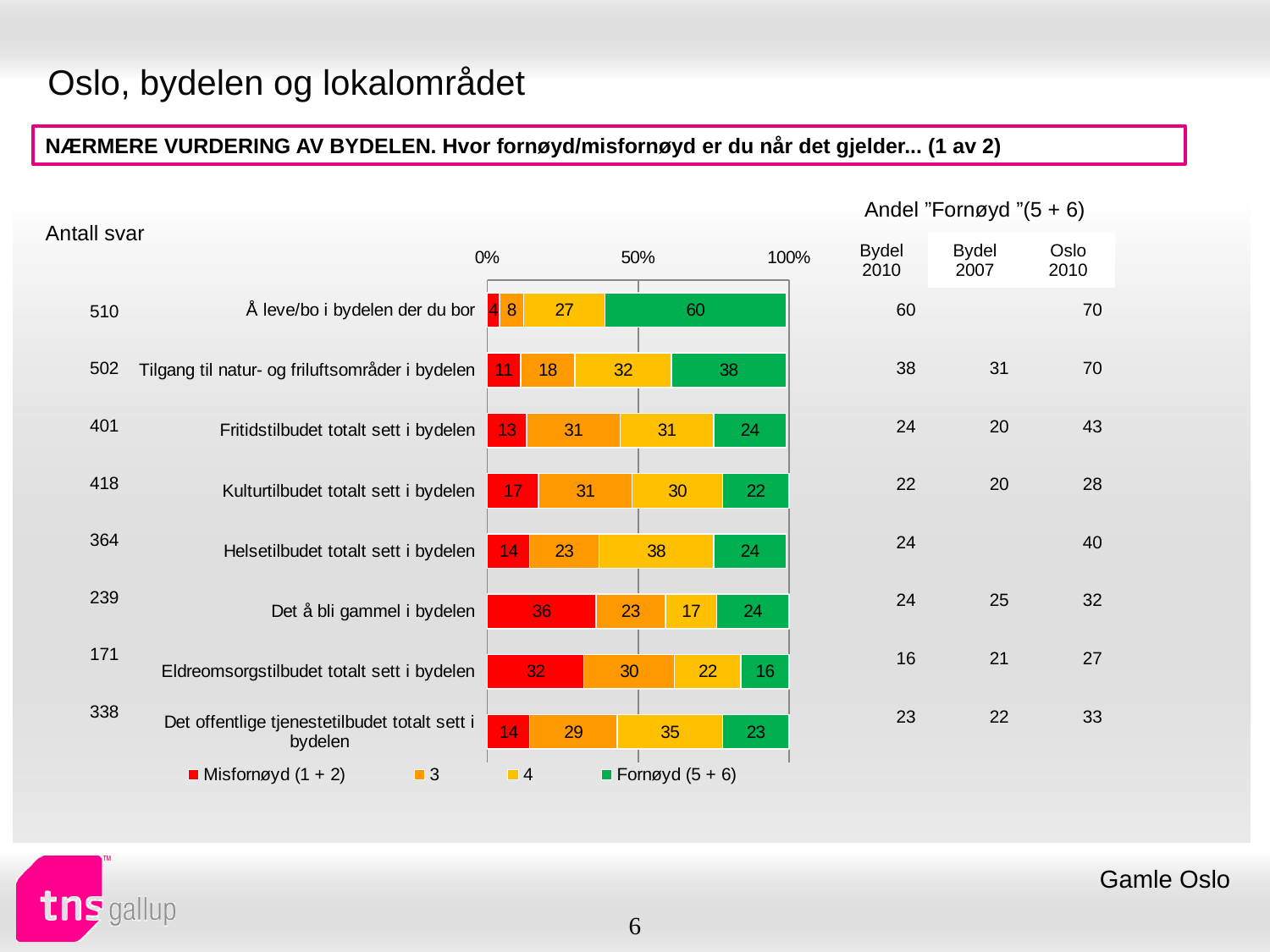
Which category has the lowest Fornøyd (5 + 6) value? Eldreomsorgstilbudet totalt sett i bydelen What is the value of the Misfornøyd (1 + 2) segment for "Det å bli gammel i bydelen"? 36 How many series does the legend list? 4 What is the difference between the Fornøyd (5 + 6) values for "Å leve/bo i bydelen der du bor" and "Tilgang til natur- og friluftsområder i bydelen"? 22 What is the total of the stacked bar for "Kulturtilbudet totalt sett i bydelen"? 100 What is the value of the Fornøyd (5 + 6) segment for "Å leve/bo i bydelen der du bor"? 60 Which is larger: the Misfornøyd (1 + 2) value for "Eldreomsorgstilbudet totalt sett i bydelen" or for "Kulturtilbudet totalt sett i bydelen"? Eldreomsorgstilbudet totalt sett i bydelen How many categories are shown in the chart? 8 Which category has the highest Misfornøyd (1 + 2) value? Det å bli gammel i bydelen What kind of chart is shown on the slide? Stacked bar chart Which category has the highest Fornøyd (5 + 6) value? Å leve/bo i bydelen der du bor What is the value of the "4" segment for "Helsetilbudet totalt sett i bydelen"? 38